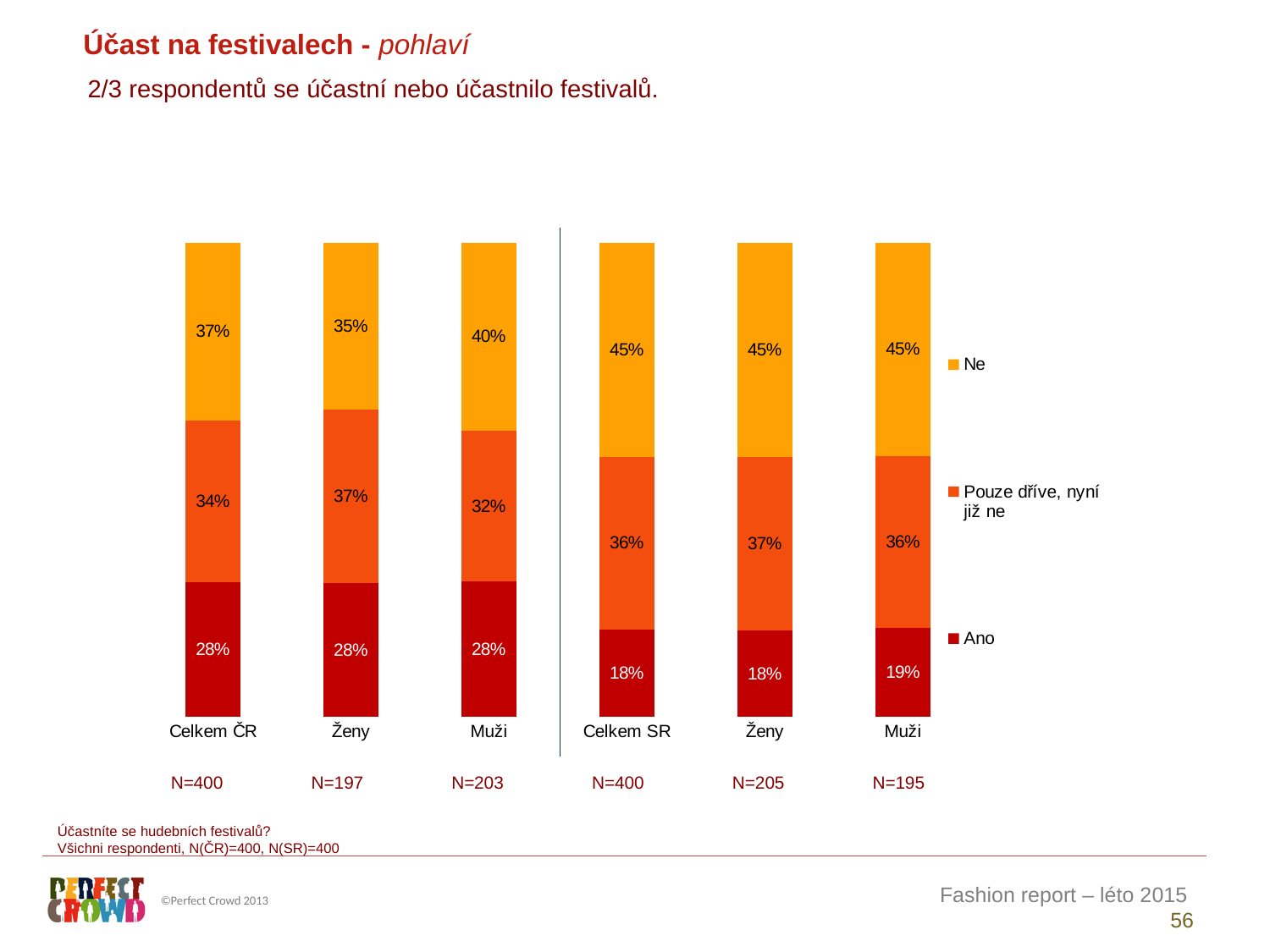
How many series does the legend list? 3 What is the total of the stacked bar for Ženy in the ČR group? 100% What is the value for "Pouze dříve, nyní již ne" for Celkem SR? 36% What is the value for "Ano" for Muži in the SR group? 19% How many bars (categories) are shown on the x axis? 6 What is the difference between the "Ne" value for Muži in the ČR group and the "Ne" value for Celkem ČR? 3 percentage points What is the value for "Ano" for Celkem ČR? 28% What is the value for "Ne" for Muži in the ČR group? 40% Among the three ČR bars (Celkem ČR, Ženy, Muži), which has the highest "Ne" value? Muži Among the three ČR bars (Celkem ČR, Ženy, Muži), which has the lowest "Pouze dříve, nyní již ne" value? Muži What kind of chart is shown on the slide? Stacked bar chart Which is larger: the "Ano" value for Celkem ČR or the "Ano" value for Celkem SR? Celkem ČR